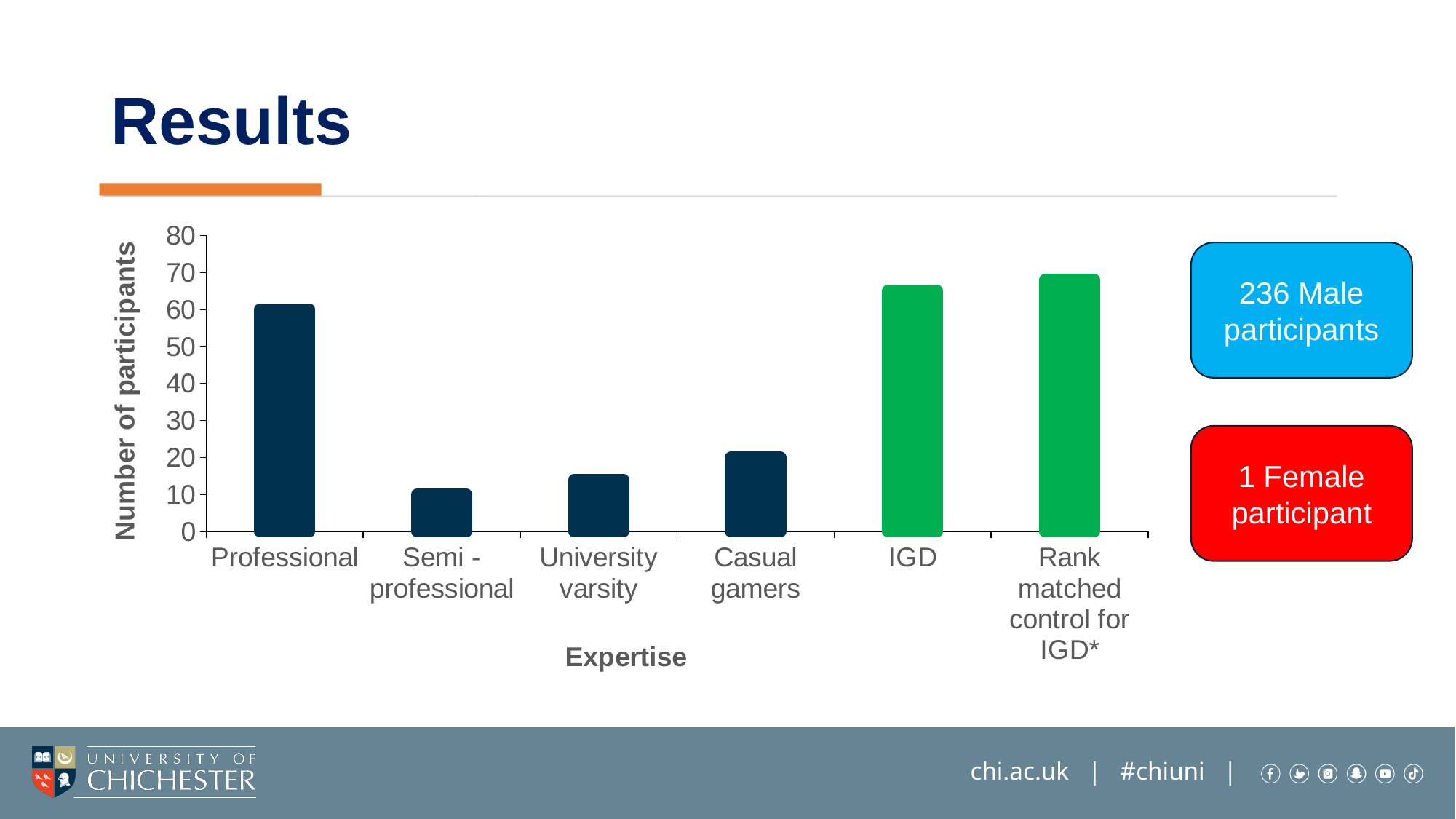
How many categories are shown on the x axis of the chart? 6 Is the value for University varsity greater or less than 20? less What kind of chart is shown on the slide? bar chart What is the title of the y axis of the chart? Number of participants Is the value for Semi - professional greater or less than 20? less Which has more participants, Professional or Casual gamers? Professional Is the value for Casual gamers greater or less than 30? less What is the title of the x axis of the chart? Expertise Which category has the lowest number of participants? Semi - professional